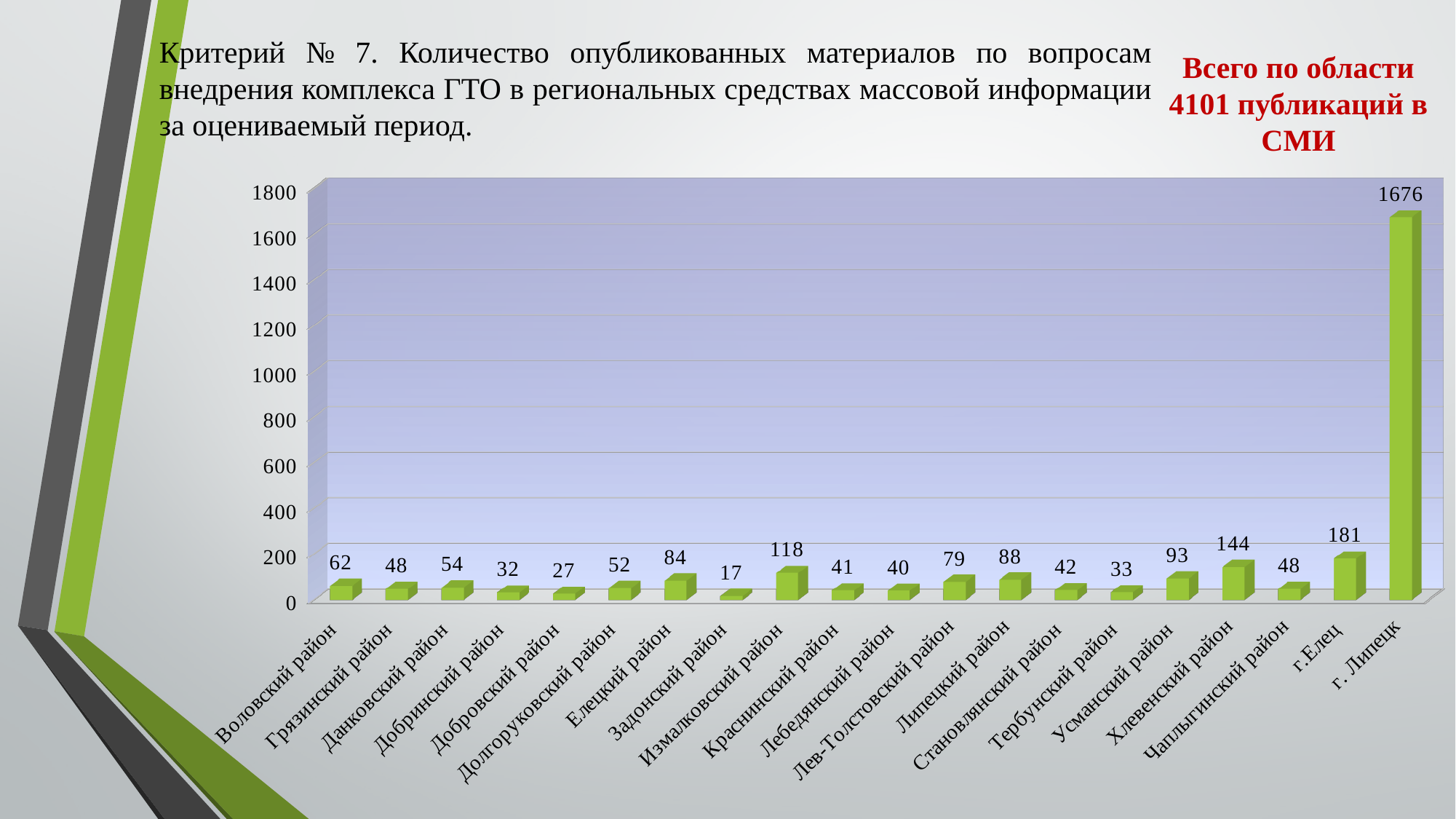
Which category has the highest value? г. Липецк What is the value for г. Липецк? 1676 What kind of chart is shown on the slide? bar chart How many categories are shown on the x axis? 20 Which category has the lowest value? Задонский район What is the value for Измалковский район? 118 What is the value for Хлевенский район? 144 What is the difference between the values for г. Липецк and г.Елец? 1495 What is the value for Задонский район? 17 What is the difference between the values for Хлевенский район and Усманский район? 51 Which is larger, the value for Елецкий район or the value for Липецкий район? Липецкий район Is the value for г. Липецк greater or less than 1600? greater